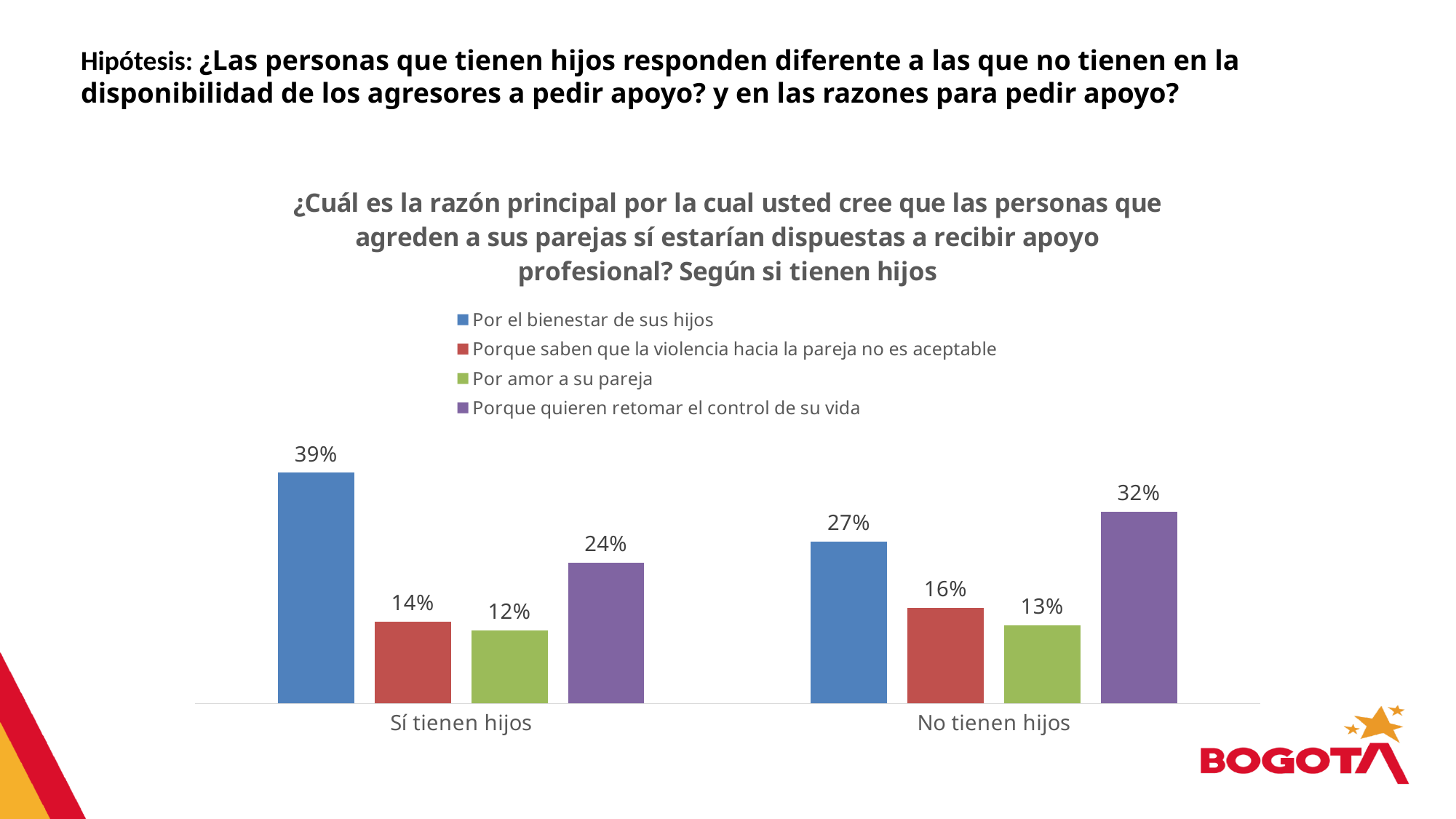
What is the value for "Porque quieren retomar el control de su vida" in the "No tienen hijos" group? 32% Which colour represents "Por amor a su pareja" in the legend? Green What is the value for "Porque saben que la violencia hacia la pareja no es aceptable" in the "No tienen hijos" group? 16% How many categories are shown on the x axis? 2 What is the value for "Por amor a su pareja" in the "Sí tienen hijos" group? 12% How many series does the legend list? 4 Which series has the lowest value in the "Sí tienen hijos" group? Por amor a su pareja Which is larger: "Porque quieren retomar el control de su vida" for "Sí tienen hijos" or for "No tienen hijos"? No tienen hijos Which series has the highest value in the "No tienen hijos" group? Porque quieren retomar el control de su vida What is the value for "Por el bienestar de sus hijos" in the "Sí tienen hijos" group? 39% What kind of chart is shown on the slide? Bar chart What is the difference between "Por el bienestar de sus hijos" for "Sí tienen hijos" and for "No tienen hijos"? 12%